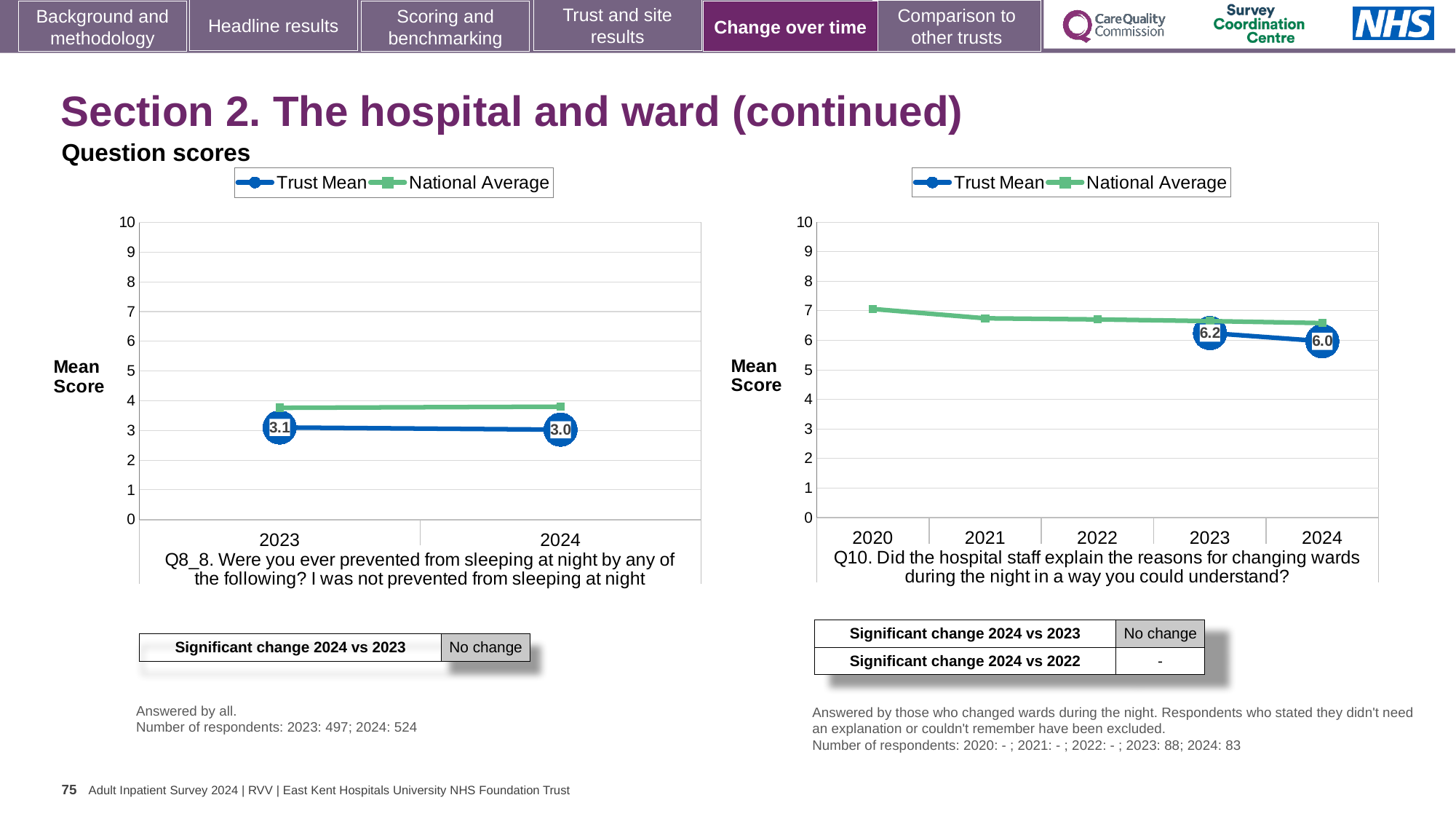
In the right chart (Q10), what is the Trust Mean score for 2024? 6.0 In the right chart (Q10), what is the difference between the Trust Mean scores for 2023 and 2024? 0.2 In the left chart (Q8_8), which year has the higher Trust Mean score, 2023 or 2024? 2023 How many series does the legend of the left chart (Q8_8) list? 2 In the left chart (Q8_8), what is the Trust Mean score for 2023? 3.1 In the left chart (Q8_8), is the National Average value for 2024 greater or less than 3? greater What type of chart is the right chart (Q10)? Line chart In the right chart (Q10), what is the Trust Mean score for 2023? 6.2 How many years are shown on the x axis of the right chart (Q10)? 5 In the left chart (Q8_8), what is the Trust Mean score for 2024? 3.0 In the right chart (Q10), is the National Average value for 2020 greater or less than 6? greater In the right chart (Q10), does the Trust Mean rise or fall from 2023 to 2024? Fall